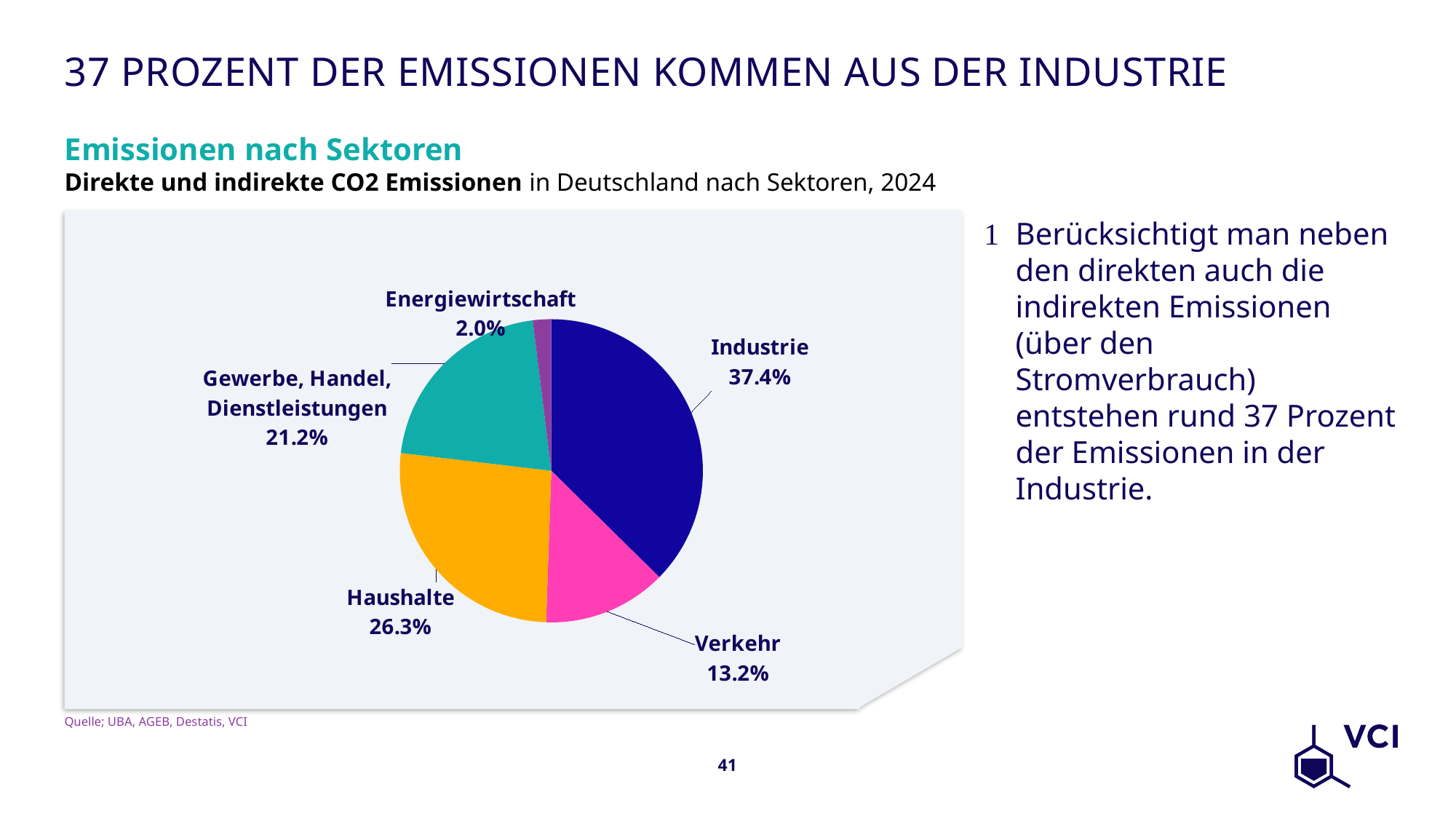
How many sectors are shown in the pie chart? 5 What share of emissions does the Haushalte slice represent? 26.3% What is the title of the chart? Emissionen nach Sektoren Which sector has the largest share of emissions? Industrie What share of emissions does the Verkehr slice represent? 13.2% What kind of chart is shown on the slide? Pie chart What share of emissions does the Gewerbe, Handel, Dienstleistungen slice represent? 21.2% What share of emissions does the Industrie slice represent? 37.4% Which has a larger share, Verkehr or Gewerbe, Handel, Dienstleistungen? Gewerbe, Handel, Dienstleistungen What share of emissions does the Energiewirtschaft slice represent? 2.0% Which sector has the smallest share of emissions? Energiewirtschaft What is the difference in percentage points between the Industrie and Haushalte shares? 11.1